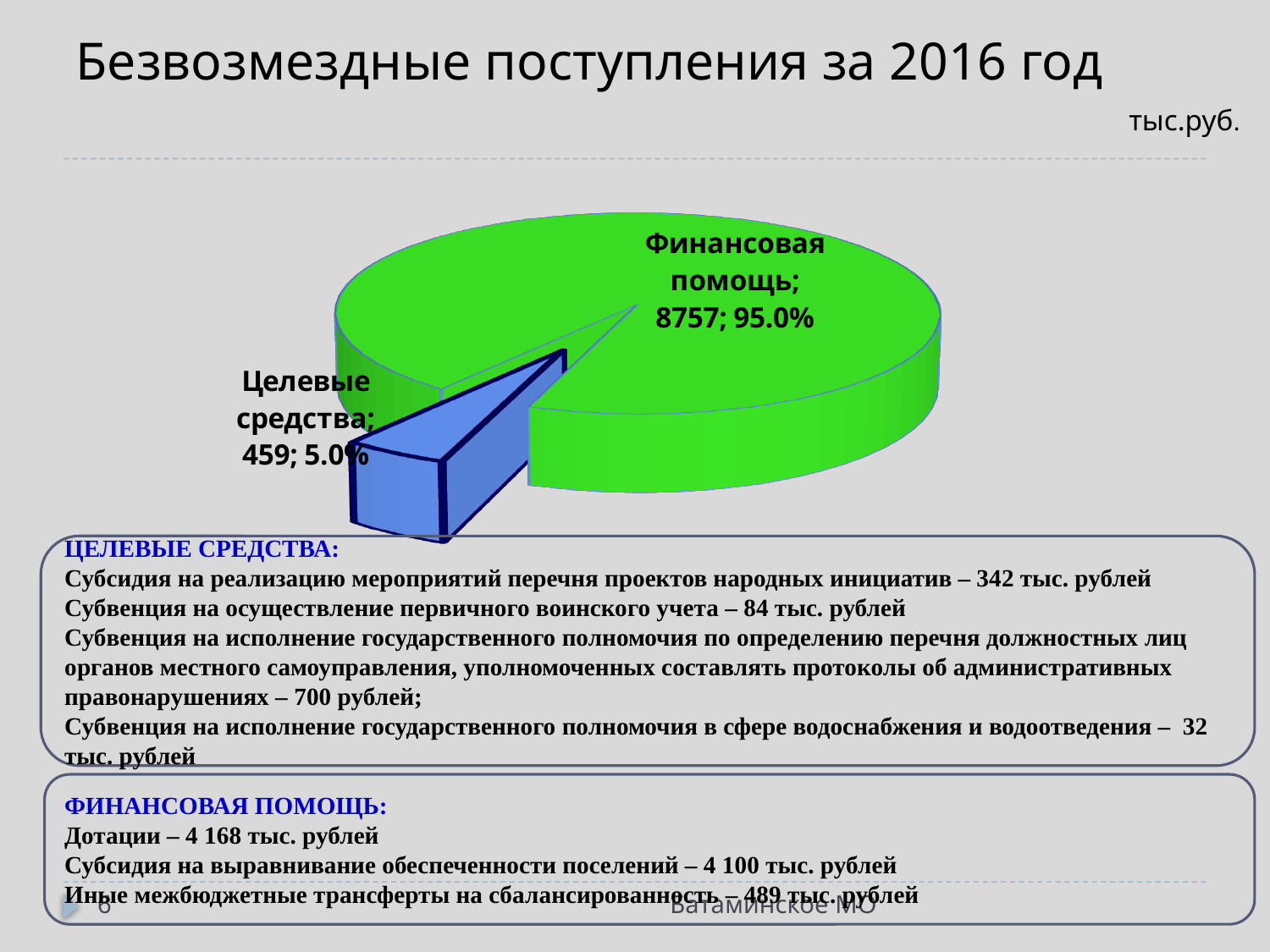
Which slice is the largest? Финансовая помощь What share of the pie does Целевые средства take? 5.0% Which slice is the smallest? Целевые средства What is the title of the slide containing the chart? Безвозмездные поступления за 2016 год What is the difference between the values for Финансовая помощь and Целевые средства? 8298 What is the value for Целевые средства? 459 What share of the pie does Финансовая помощь take? 95.0% How many slices does the pie chart have? 2 What colour is the Целевые средства slice? blue What is the value for Финансовая помощь? 8757 Which is larger, Финансовая помощь or Целевые средства? Финансовая помощь What type of chart is shown on the slide? pie chart